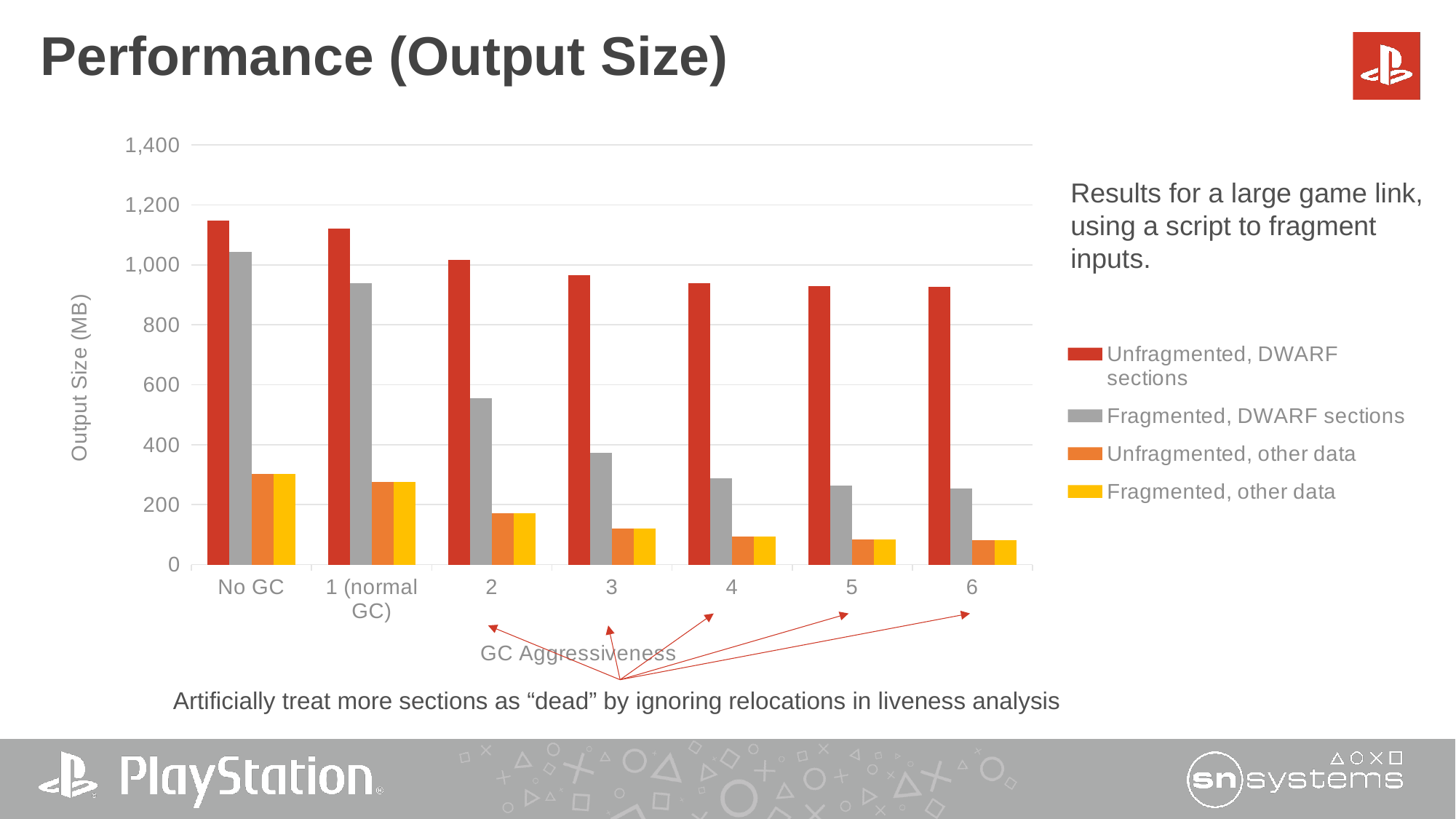
Is the value for Fragmented, DWARF sections at No GC greater or less than 1,000? greater How many series does the chart's legend list? 4 Is the value for Fragmented, DWARF sections at GC aggressiveness 2 greater or less than 600? less Which category has the highest value for the Fragmented, DWARF sections series? No GC Is the value for Unfragmented, other data at No GC greater or less than 200? greater What kind of chart is shown on the slide? bar chart At GC aggressiveness 3, which is larger: Unfragmented, DWARF sections or Fragmented, DWARF sections? Unfragmented, DWARF sections How many categories are shown along the x axis of the chart? 7 Do the values for Fragmented, DWARF sections rise or fall as GC aggressiveness increases along the x axis? fall Which category has the highest value for the Unfragmented, DWARF sections series? No GC What is the title of the chart's vertical axis? Output Size (MB)